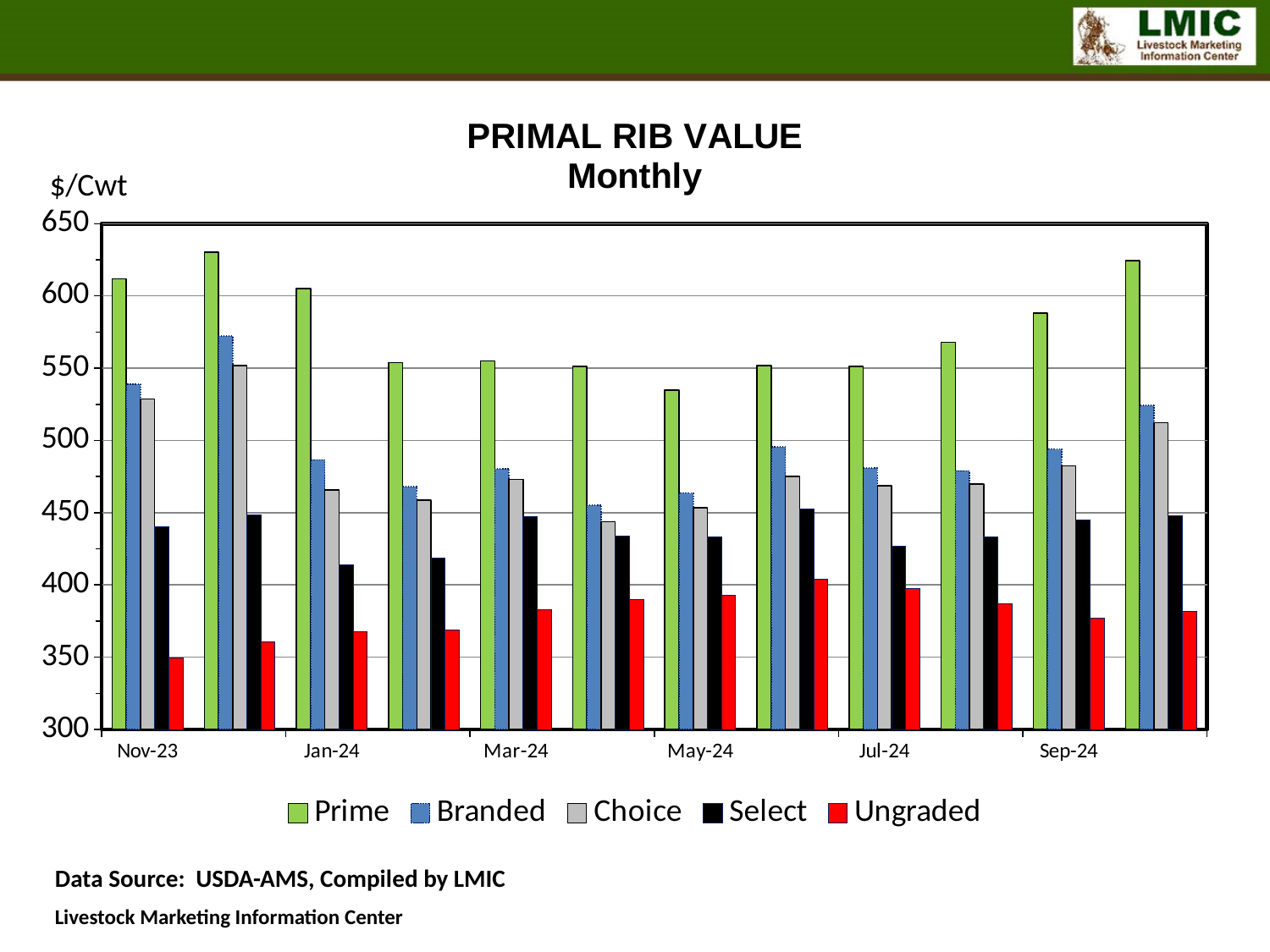
Which series has the highest value in every month shown? Prime Which is larger, the Branded value for Nov-23 or the Branded value for Jan-24? Nov-23 Is the Prime value for Nov-23 greater or less than 600? greater What unit is shown on the y axis of the chart? $/Cwt Is the Prime value for May-24 greater or less than 550? less How many groups of bars (months) are plotted in the chart? 12 Does the Ungraded value rise or fall from Nov-23 to May-24? rise Is the Select value for Jan-24 greater or less than 400? greater What kind of chart is shown on the slide? bar chart Among the labeled months, in which month is the Prime value lowest? May-24 How many series does the legend list? 5